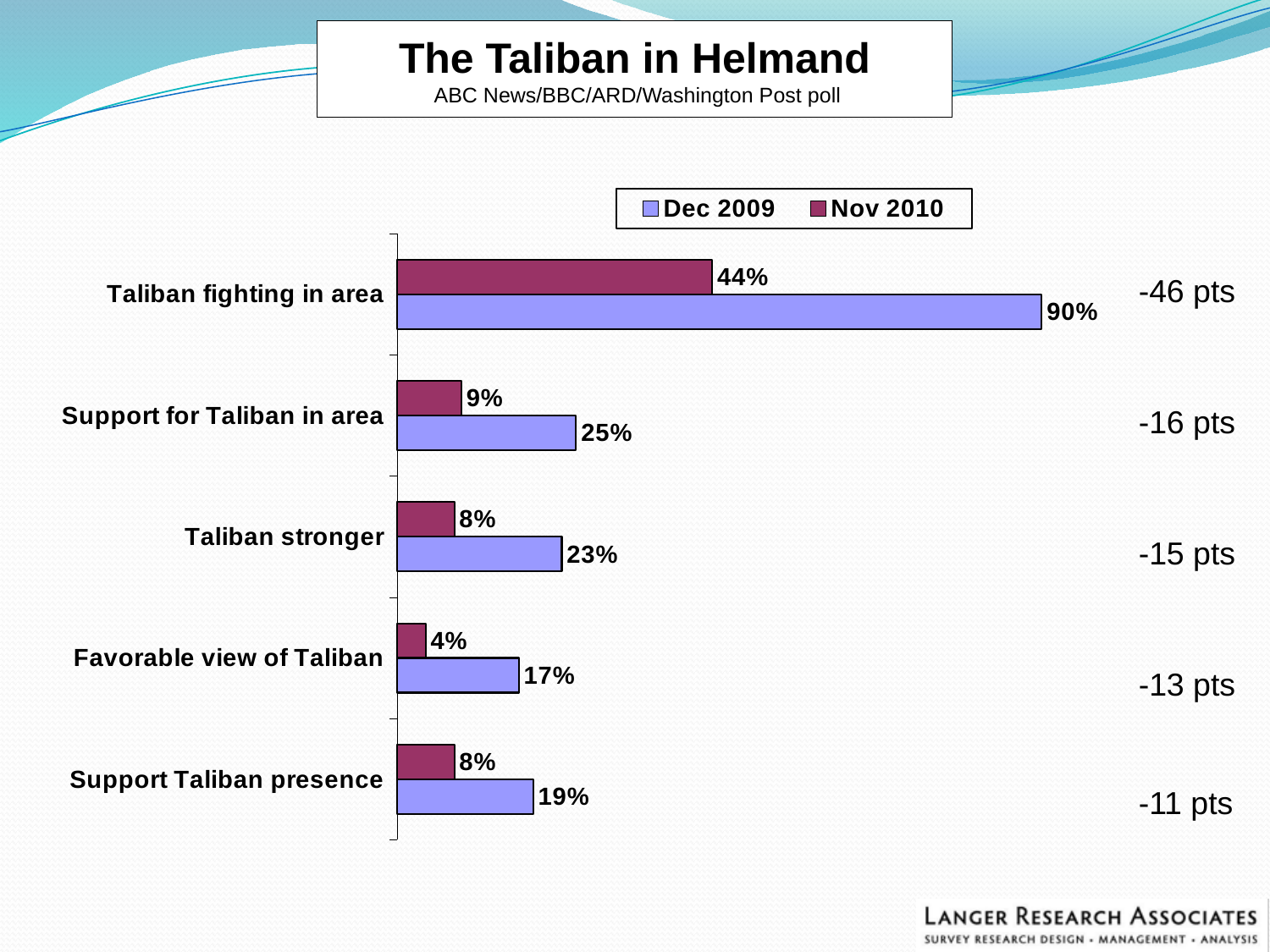
What is the difference between the Dec 2009 and Nov 2010 values for "Taliban stronger"? 15 percentage points What was the Nov 2010 value for "Support for Taliban in area"? 9% Which category has the lowest Dec 2009 value? Favorable view of Taliban What kind of chart is shown on the slide? Bar chart Which is larger: the Dec 2009 value for "Support Taliban presence" or the Dec 2009 value for "Favorable view of Taliban"? Support Taliban presence What is the title of the chart? The Taliban in Helmand What was the Dec 2009 value for "Favorable view of Taliban"? 17% Which category has the lowest Nov 2010 value? Favorable view of Taliban How many series does the legend list? 2 Which category has the highest Nov 2010 value? Taliban fighting in area How many categories are shown on the chart? 5 What was the Dec 2009 value for "Taliban fighting in area"? 90%